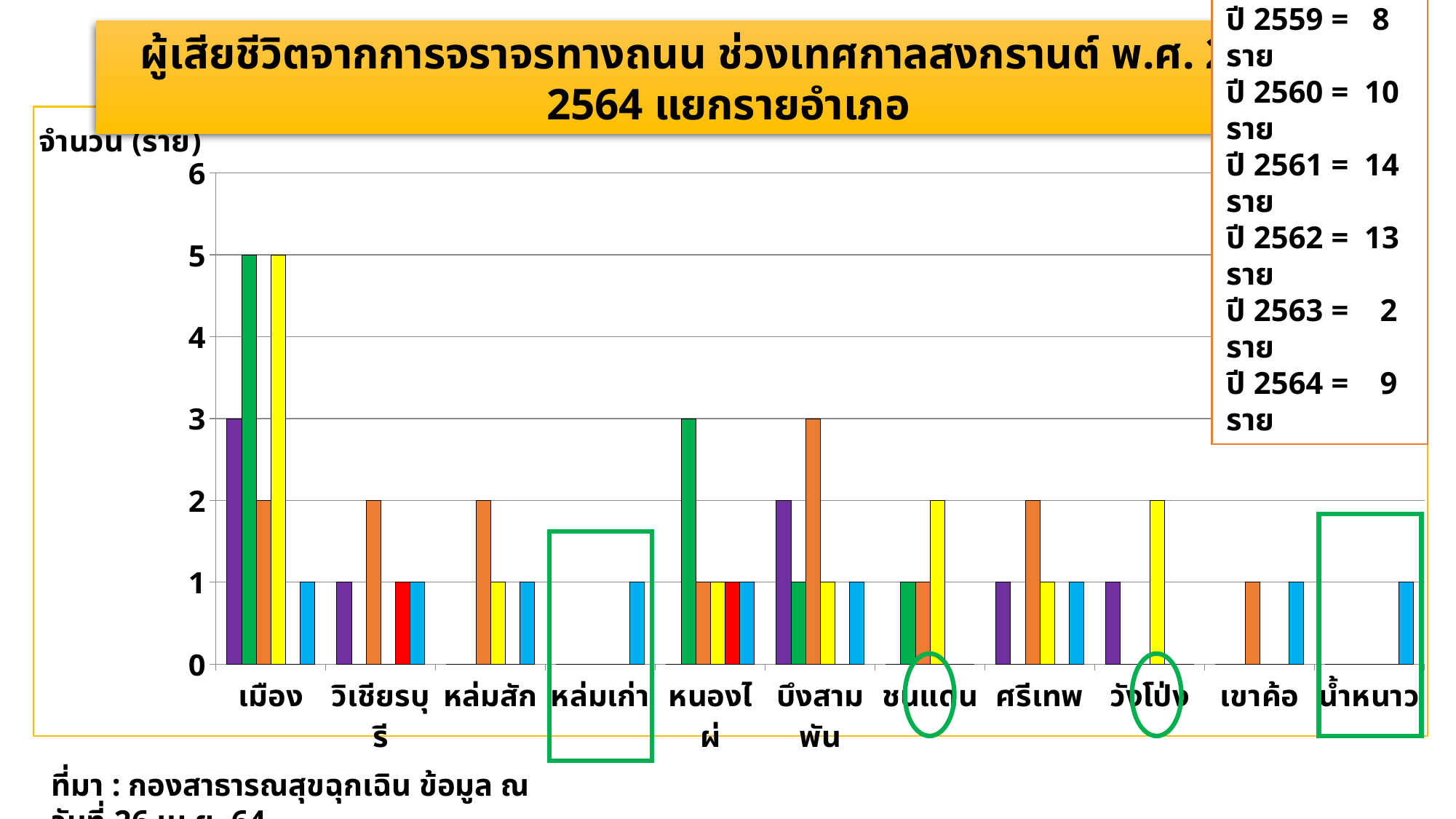
What is the value of the single bar shown for หล่มเก่า? 1 What kind of chart is shown on the slide? bar chart What is the value of the single bar shown for น้ำหนาว? 1 What is the value of the tallest bar for หนองไผ่? 3 What is the value of the tallest bar for บึงสามพัน? 3 How many districts (categories) are shown along the x axis of the chart? 11 What is the label on the y axis of the chart? จำนวน (ราย) Which district has a taller maximum bar, ศรีเทพ or หนองไผ่? หนองไผ่ What is the value of the tallest bar for วังโป่ง? 2 Which district has the tallest bar in the chart? เมือง What is the value of the tallest bar for เมือง? 5 How many bars are shown for เขาค้อ? 2